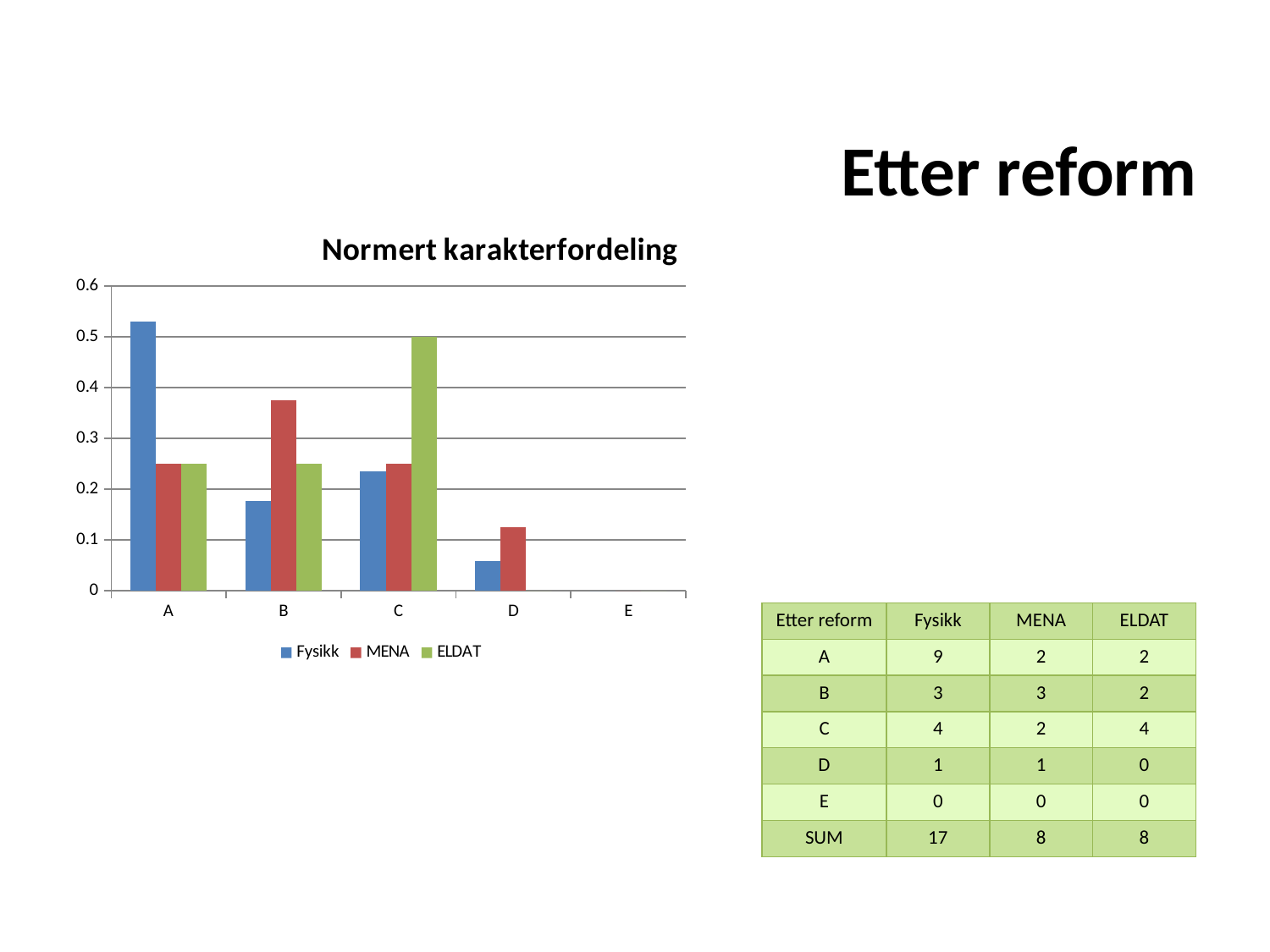
Is the Fysikk value for A greater or less than 0.4? greater Which category has the highest ELDAT bar? C What kind of chart is shown on the slide? bar chart For category C, which is larger: the ELDAT value or the Fysikk value? ELDAT What is the title of the chart? Normert karakterfordeling Is the Fysikk value for D greater or less than 0.1? less How many categories are shown on the x axis of the chart? 5 For category A, which is larger: the Fysikk value or the MENA value? Fysikk How many series does the chart legend list? 3 Which category has the highest Fysikk bar? A Which category has the highest MENA bar? B Is the MENA value for B greater or less than 0.3? greater